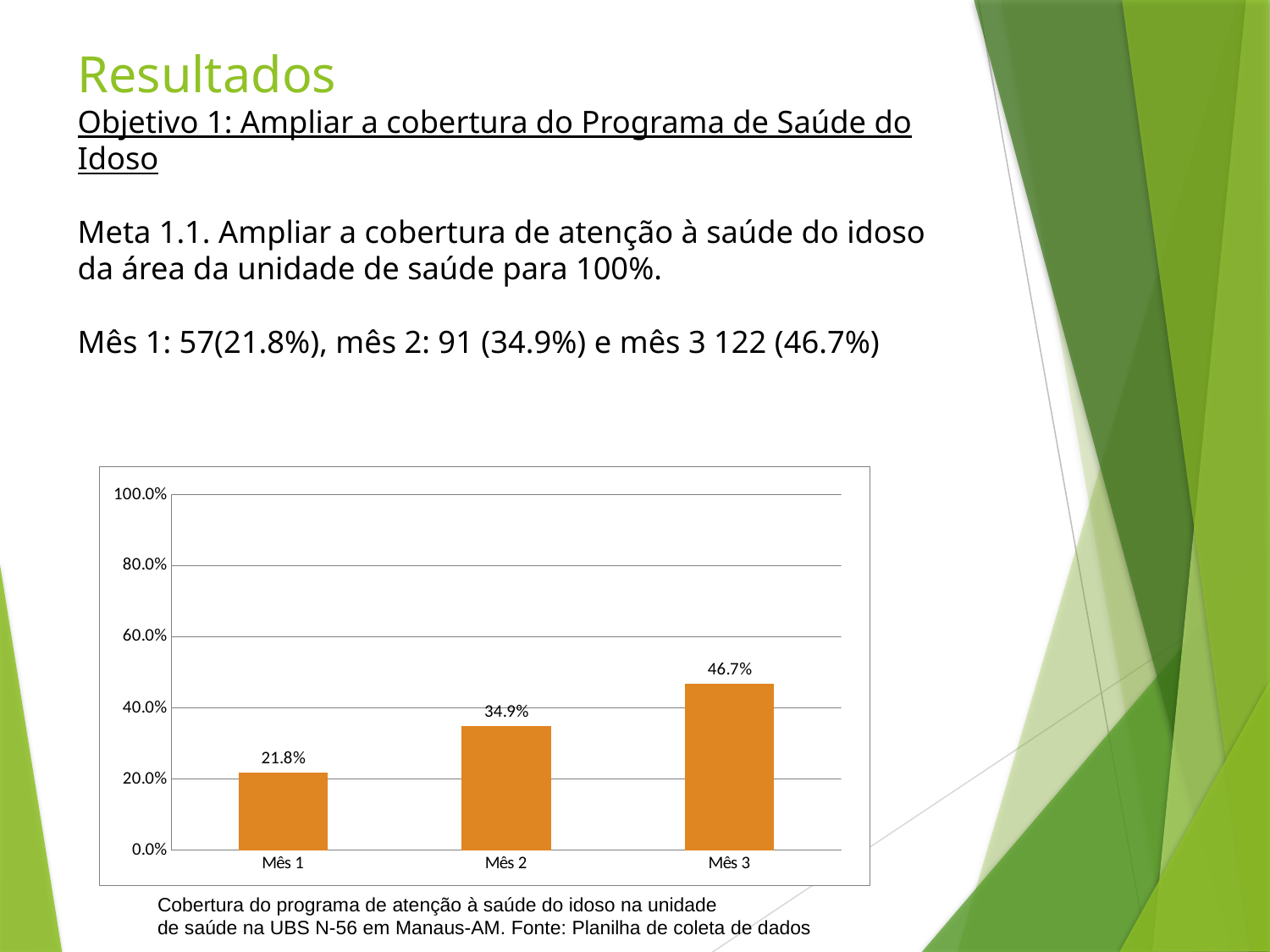
What kind of chart is shown on the slide? bar chart What is the difference between the values for Mês 2 and Mês 1? 13.1% What is the difference between the values for Mês 3 and Mês 1? 24.9% Which month has the highest value? Mês 3 What is the value for Mês 3? 46.7% What is the value for Mês 2? 34.9% Which month has the lowest value? Mês 1 Is the value for Mês 3 greater or less than 40.0%? greater Do the values rise or fall from Mês 1 to Mês 3? rise What is the value for Mês 1? 21.8% Which is larger, the value for Mês 2 or the value for Mês 3? Mês 3 How many categories are shown on the x axis? 3